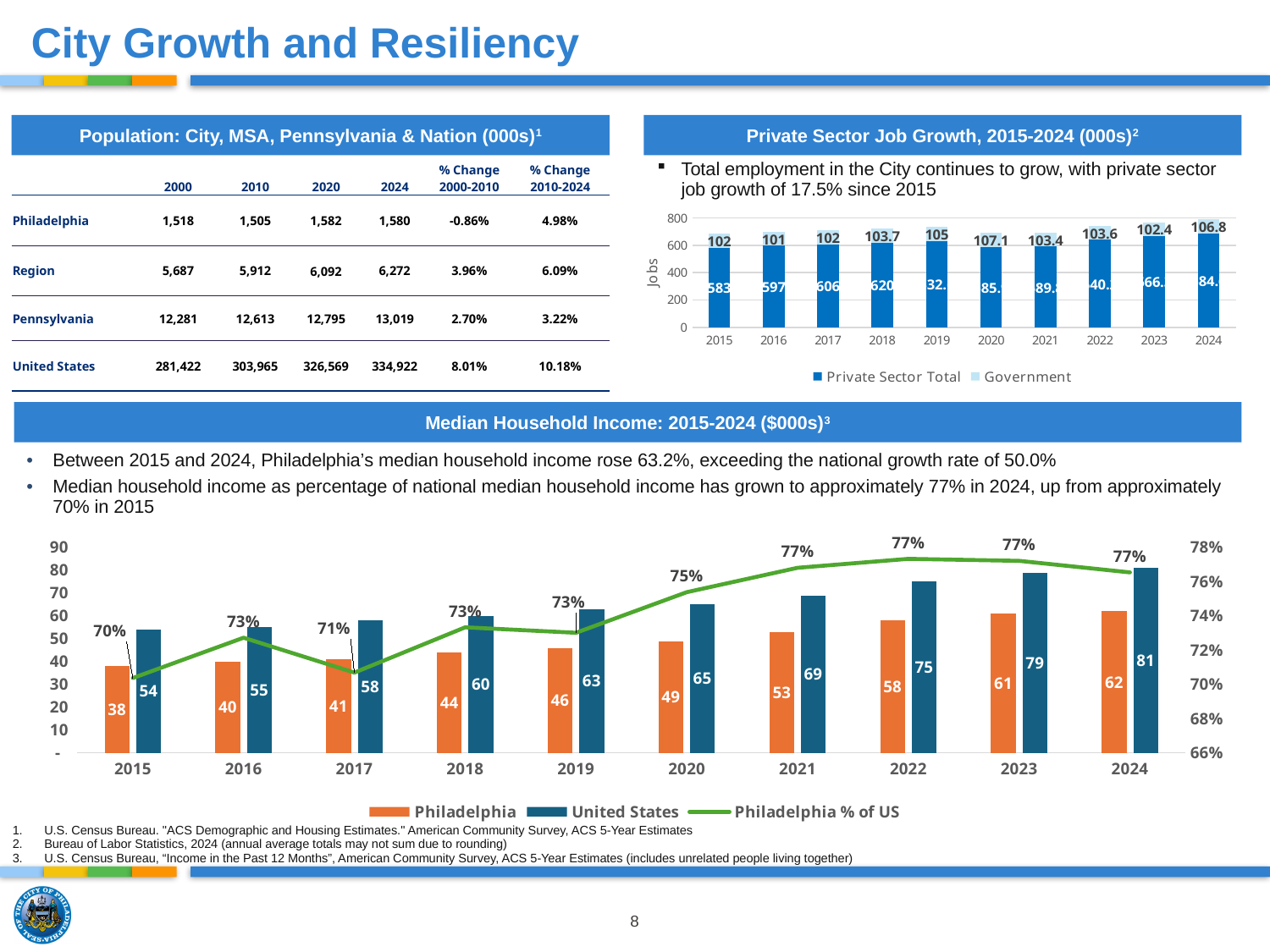
In the Private Sector Job Growth chart, what is the total of the stacked bar for 2015? 685 In the Median Household Income chart, what is the value for United States in 2024? 81 In the Private Sector Job Growth chart, what is the Government value for 2020? 107.1 In the Median Household Income chart, what is the value for Philadelphia in 2015? 38 In the Median Household Income chart, how many series does the legend list? 3 In the Median Household Income chart, which year has the highest Philadelphia value? 2024 In the Median Household Income chart, what is the Philadelphia % of US value for 2020? 75% In the Median Household Income chart, do the United States values rise or fall from 2015 to 2024? rise What kind of chart is the Private Sector Job Growth chart? stacked bar chart In the Private Sector Job Growth chart, how many years are shown on the x axis? 10 In the Median Household Income chart, what is the difference between the United States and Philadelphia values in 2022? 17 In the Private Sector Job Growth chart, what is the Private Sector Total value for 2018? 620